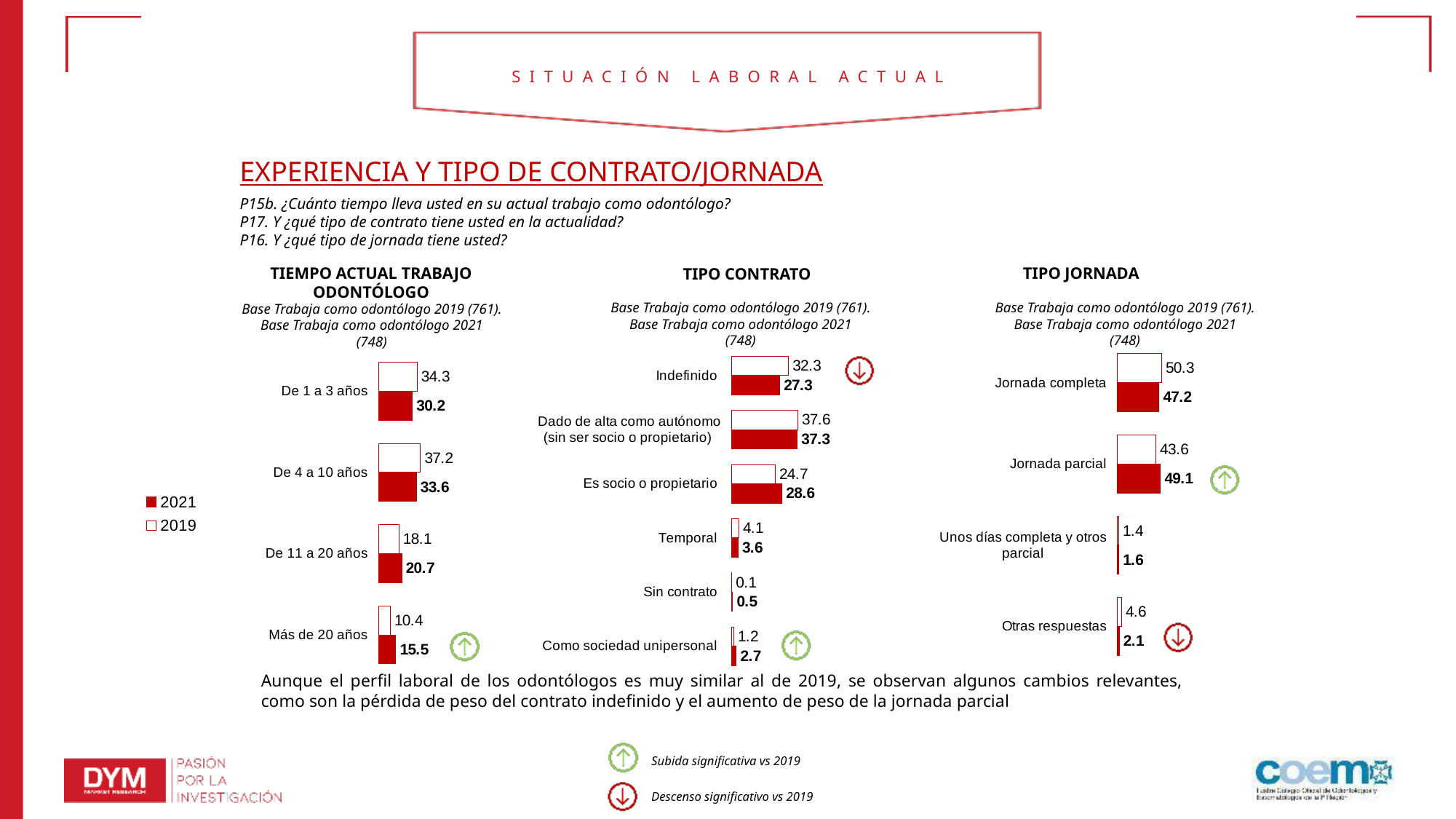
In the TIPO JORNADA chart, what is the difference between the 2019 and 2021 values for 'Otras respuestas'? 2.5 In the TIEMPO ACTUAL TRABAJO ODONTÓLOGO chart, what is the 2021 value for 'De 4 a 10 años'? 33.6 In the TIPO CONTRATO chart, which category has the lowest 2019 value? Sin contrato How many series does the legend list? 2 In the TIPO JORNADA chart, what is the 2021 value for 'Jornada parcial'? 49.1 In the TIPO CONTRATO chart, what is the 2021 value for 'Es socio o propietario'? 28.6 In the TIEMPO ACTUAL TRABAJO ODONTÓLOGO chart, what is the difference between the 2021 and 2019 values for 'Más de 20 años'? 5.1 In the TIEMPO ACTUAL TRABAJO ODONTÓLOGO chart, which category has the highest 2021 value? De 4 a 10 años In the TIPO CONTRATO chart, is the 2019 value for 'Indefinido' larger or smaller than the 2021 value? larger In the TIPO CONTRATO chart, how many categories are shown? 6 What type of chart is the TIPO JORNADA chart? Bar chart In the TIEMPO ACTUAL TRABAJO ODONTÓLOGO chart, what is the 2019 value for 'Más de 20 años'? 10.4